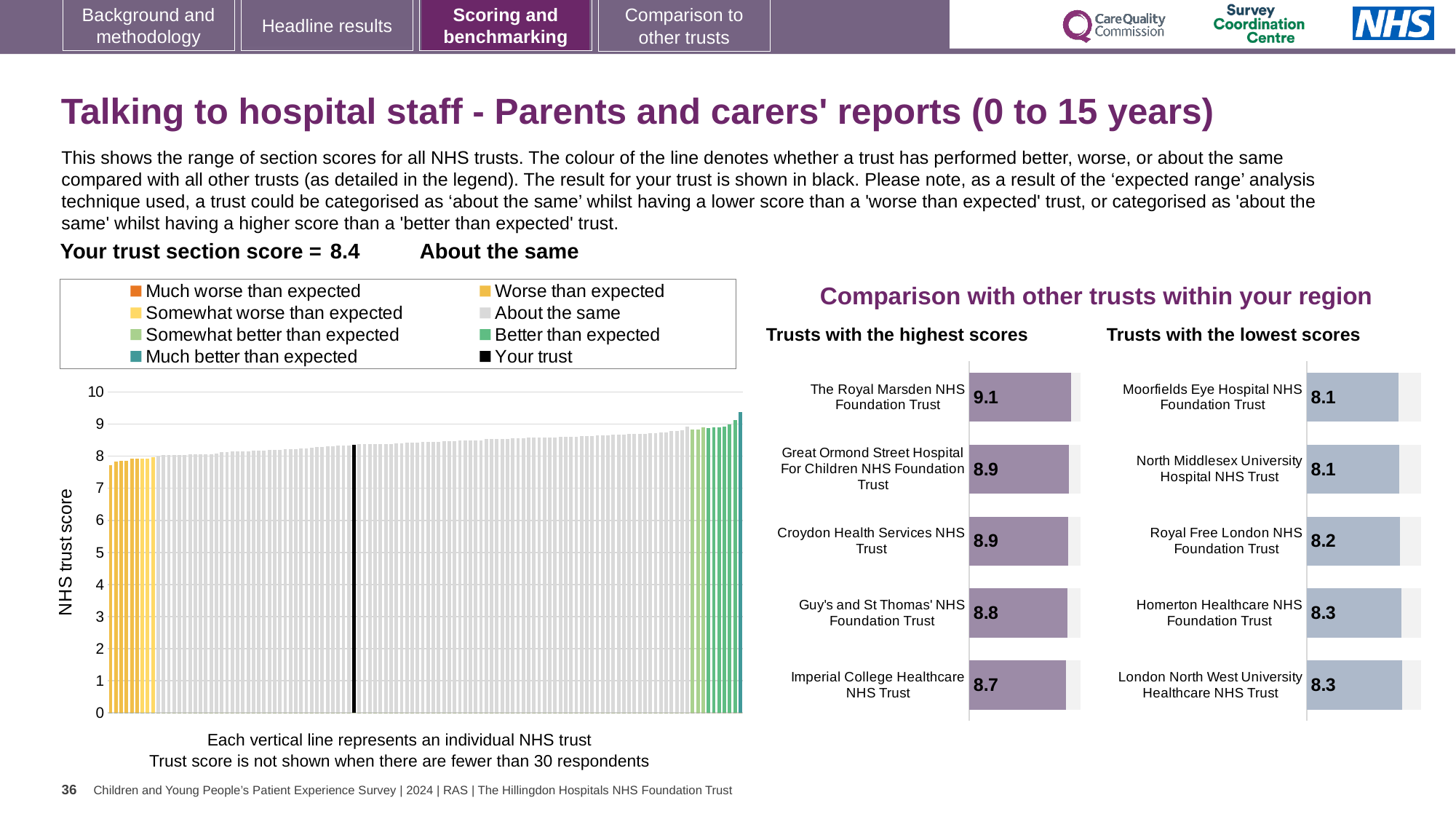
In the large chart on the left, is the value for the black 'Your trust' bar greater or less than 8? greater In the 'Trusts with the highest scores' chart, which trust has the lowest score shown? Imperial College Healthcare NHS Trust In the 'Trusts with the lowest scores' chart, what is the score for Royal Free London NHS Foundation Trust? 8.2 In the 'Trusts with the highest scores' chart, what is the difference between the scores of The Royal Marsden NHS Foundation Trust and Imperial College Healthcare NHS Trust? 0.4 In the 'Trusts with the lowest scores' chart, what is the difference between the scores of London North West University Healthcare NHS Trust and Moorfields Eye Hospital NHS Foundation Trust? 0.2 In the 'Trusts with the highest scores' chart, which has the higher score: Croydon Health Services NHS Trust or Guy's and St Thomas' NHS Foundation Trust? Croydon Health Services NHS Trust In the 'Trusts with the highest scores' chart, what is the score for The Royal Marsden NHS Foundation Trust? 9.1 In the 'Trusts with the lowest scores' chart, what is the score for Homerton Healthcare NHS Foundation Trust? 8.3 What kind of chart is the large chart on the left showing NHS trust scores? Bar chart In the 'Trusts with the lowest scores' chart, which has the higher score: Royal Free London NHS Foundation Trust or Homerton Healthcare NHS Foundation Trust? Homerton Healthcare NHS Foundation Trust How many trusts are listed in the 'Trusts with the highest scores' chart? 5 How many entries does the legend of the large chart on the left list? 8